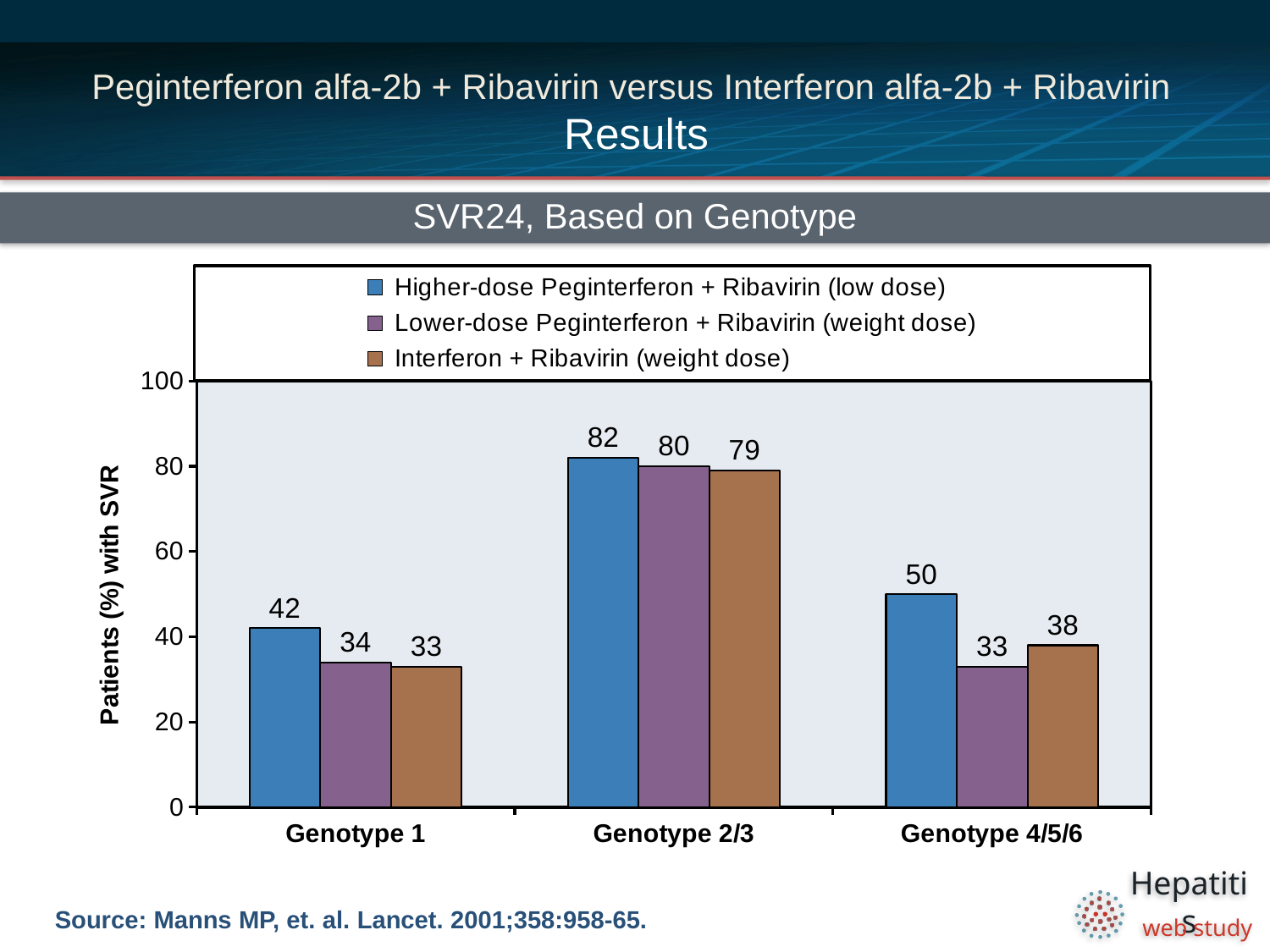
In Genotype 4/5/6, which is larger: the SVR rate for Lower-dose Peginterferon + Ribavirin (weight dose) or for Interferon + Ribavirin (weight dose)? Interferon + Ribavirin (weight dose) How many series does the legend list? 3 What is the label of the y axis? Patients (%) with SVR Is the SVR rate for Higher-dose Peginterferon + Ribavirin (low dose) in Genotype 2/3 greater or less than 80? greater What is the SVR rate for Interferon + Ribavirin (weight dose) in Genotype 2/3? 79 What is the SVR rate for Higher-dose Peginterferon + Ribavirin (low dose) in Genotype 1? 42 What is the difference between the Higher-dose Peginterferon + Ribavirin (low dose) and Lower-dose Peginterferon + Ribavirin (weight dose) SVR rates in Genotype 4/5/6? 17 Which genotype group has the lowest SVR rate for Interferon + Ribavirin (weight dose)? Genotype 1 What kind of chart is shown on the slide? Bar chart How many genotype groups are shown on the x axis? 3 Which genotype group has the highest SVR rate for Higher-dose Peginterferon + Ribavirin (low dose)? Genotype 2/3 What is the SVR rate for Lower-dose Peginterferon + Ribavirin (weight dose) in Genotype 4/5/6? 33